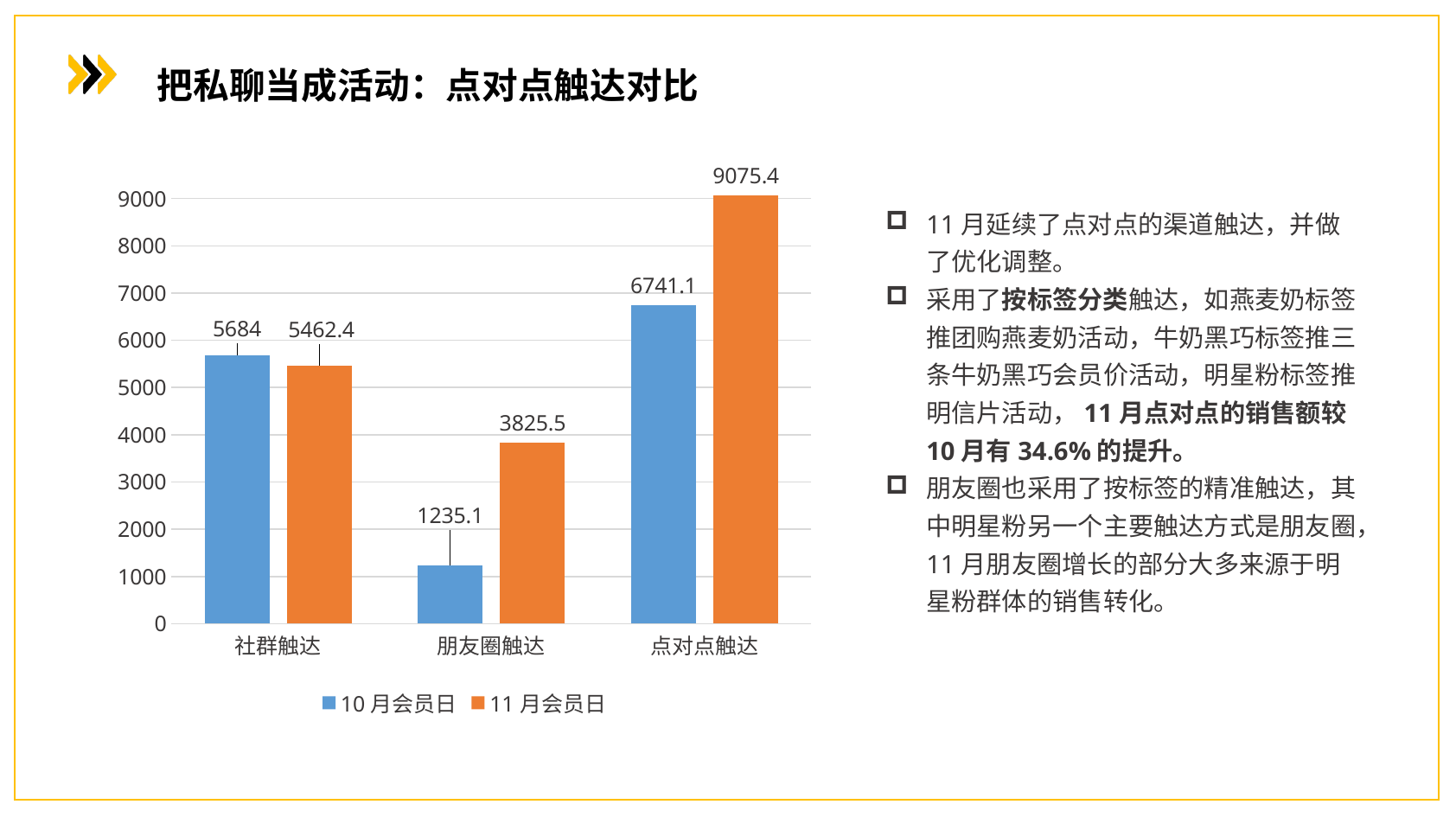
Which category has the highest value in the 11 月会员日 series? 点对点触达 What is the difference between the 11 月会员日 and 10 月会员日 values for 点对点触达? 2334.3 What is the value for 社群触达 in the 10 月会员日 series? 5684 What colour are the bars for the 11 月会员日 series? orange How many series does the legend list? 2 What is the value for 朋友圈触达 in the 10 月会员日 series? 1235.1 What kind of chart is shown on the slide? bar chart How many categories are shown on the x axis? 3 For 社群触达, which series has the larger value, 10 月会员日 or 11 月会员日? 10 月会员日 What is the value for 点对点触达 in the 11 月会员日 series? 9075.4 Which category has the lowest value in the 10 月会员日 series? 朋友圈触达 Is the value for 朋友圈触达 in the 11 月会员日 series greater or less than 4000? less